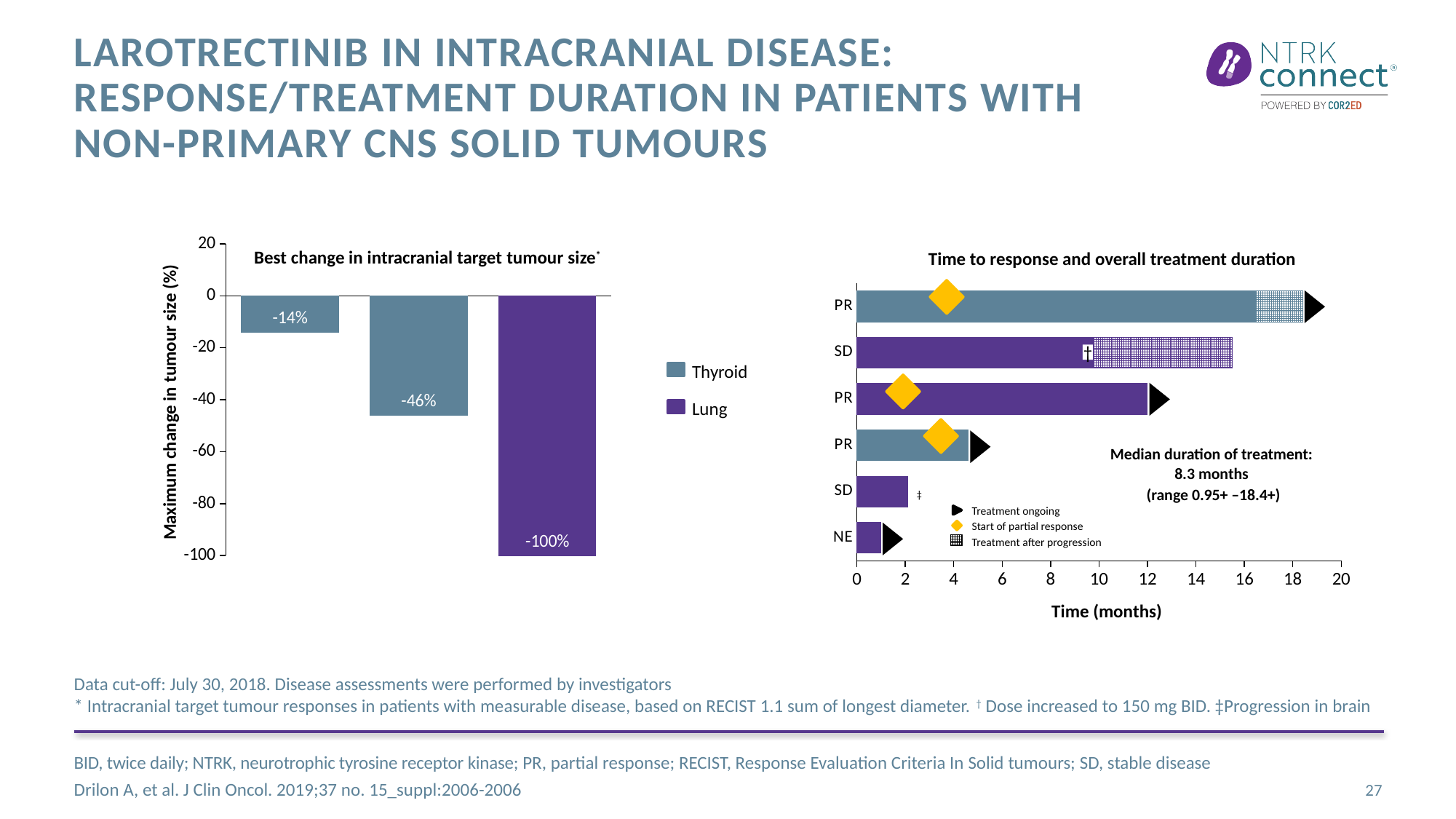
In the 'Time to response and overall treatment duration' chart, is the treatment duration of the top PR bar greater or less than 16 months? greater In the 'Best change in intracranial target tumour size' chart, how many series does the legend list? 2 What kind of chart is the 'Best change in intracranial target tumour size' chart? Bar chart In the 'Best change in intracranial target tumour size' chart, what is the value of the middle bar? -46% In the 'Best change in intracranial target tumour size' chart, what is the value of the smallest thyroid bar? -14% In the 'Best change in intracranial target tumour size' chart, what is the value of the lung bar? -100% In the 'Best change in intracranial target tumour size' chart, how many bars are plotted? 3 In the 'Time to response and overall treatment duration' chart, is the treatment duration of the NE bar greater or less than 2 months? less In the 'Best change in intracranial target tumour size' chart, which tumour type shows the largest reduction in tumour size? Lung In the 'Best change in intracranial target tumour size' chart, what is the difference in percentage points between the two thyroid bars (-14% and -46%)? 32 percentage points In the 'Time to response and overall treatment duration' chart, what median duration of treatment is stated? 8.3 months In the 'Time to response and overall treatment duration' chart, how many patient bars are plotted? 6